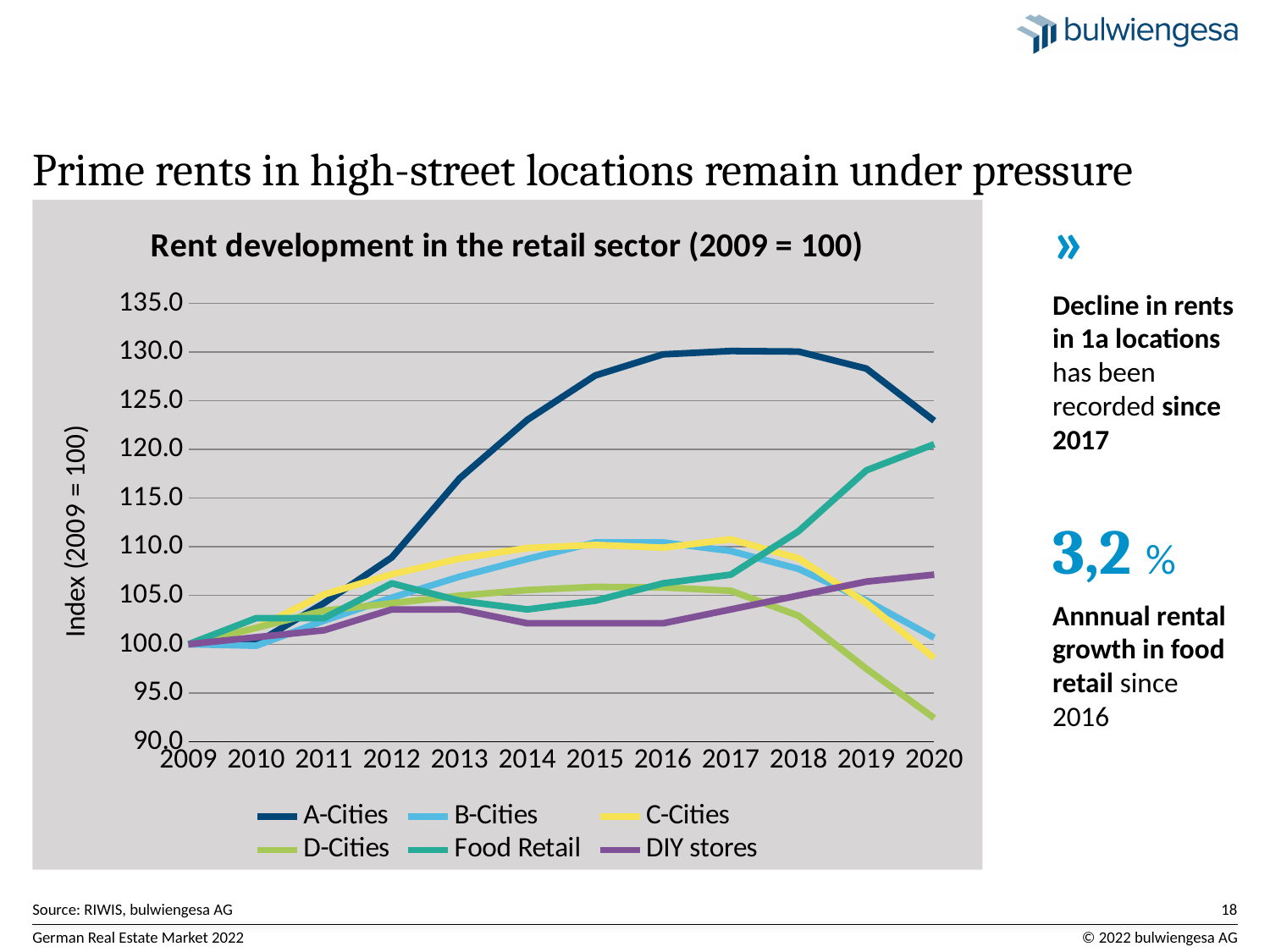
Is the value for A-Cities in 2020 greater or less than 120.0? greater Which series has the highest value in 2020? A-Cities What is the title of the chart? Rent development in the retail sector (2009 = 100) How many series does the legend list? 6 How many years are plotted along the x axis? 12 Which series has the lowest value in 2020? D-Cities Is the value for D-Cities in 2020 greater or less than 95.0? less Do the values for A-Cities rise or fall from 2017 to 2020? fall In 2015, which is larger: A-Cities or Food Retail? A-Cities Which series has the highest value in 2016? A-Cities What is the index value for A-Cities in 2009? 100.0 What kind of chart is shown on the slide? line chart